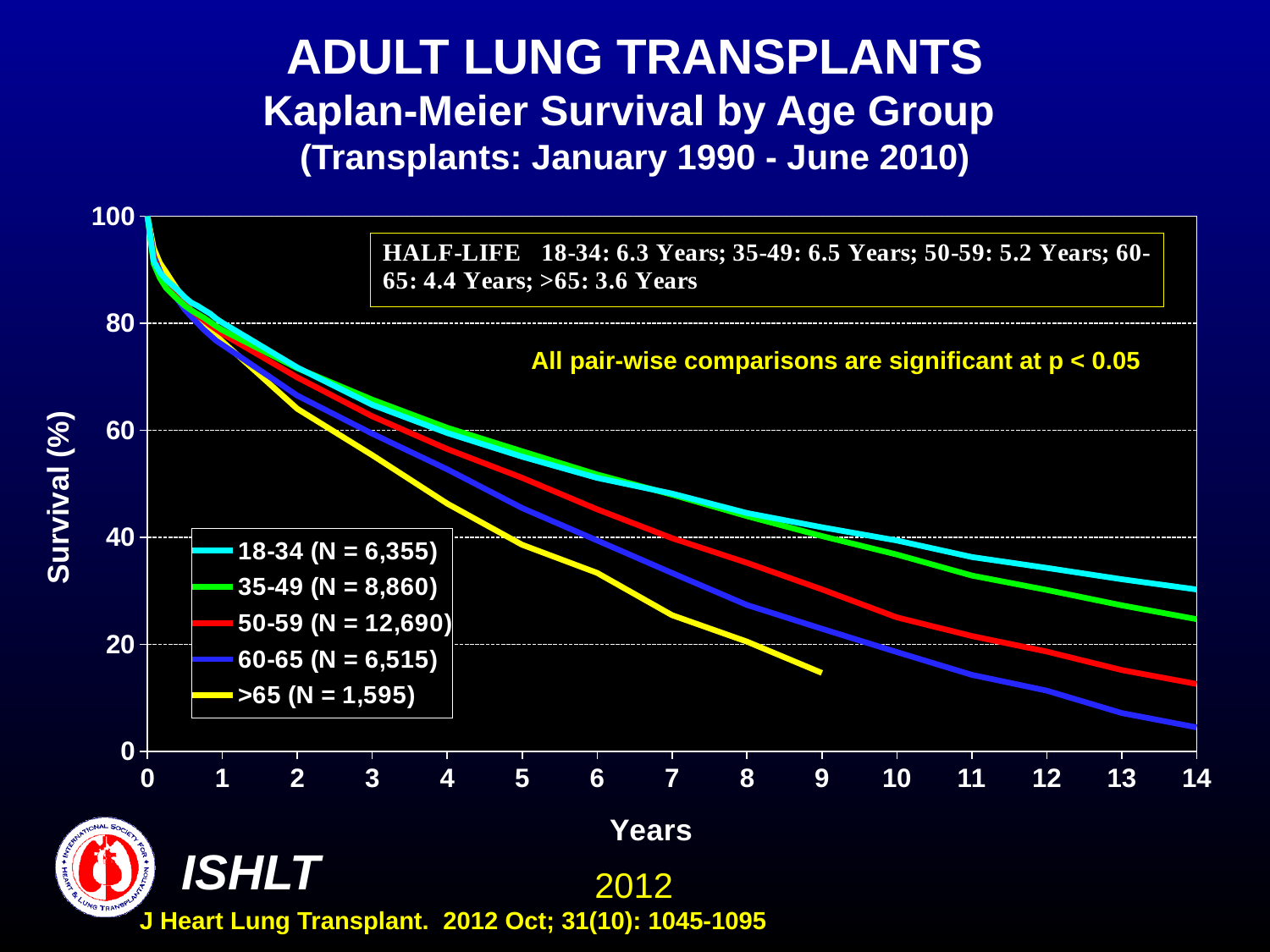
What is the label of the y axis? Survival (%) Is the survival for the >65 group at 9 years greater or less than 20%? less What kind of chart is shown on the slide? Line chart At 14 years, which group has higher survival: 35-49 or 60-65? 35-49 What is the difference in half-life between the 18-34 group and the >65 group? 2.7 Years How many age groups (series) does the legend list? 5 Is the survival for the 18-34 group at 14 years greater or less than 20%? greater What is the N for the 35-49 age group shown in the legend? 8,860 What is the half-life for the 50-59 age group according to the text box? 5.2 Years Which age group has the largest N in the legend? 50-59 (N = 12,690) Do the survival curves rise or fall as years increase? Fall Which age group has the shortest half-life? >65 (3.6 Years)